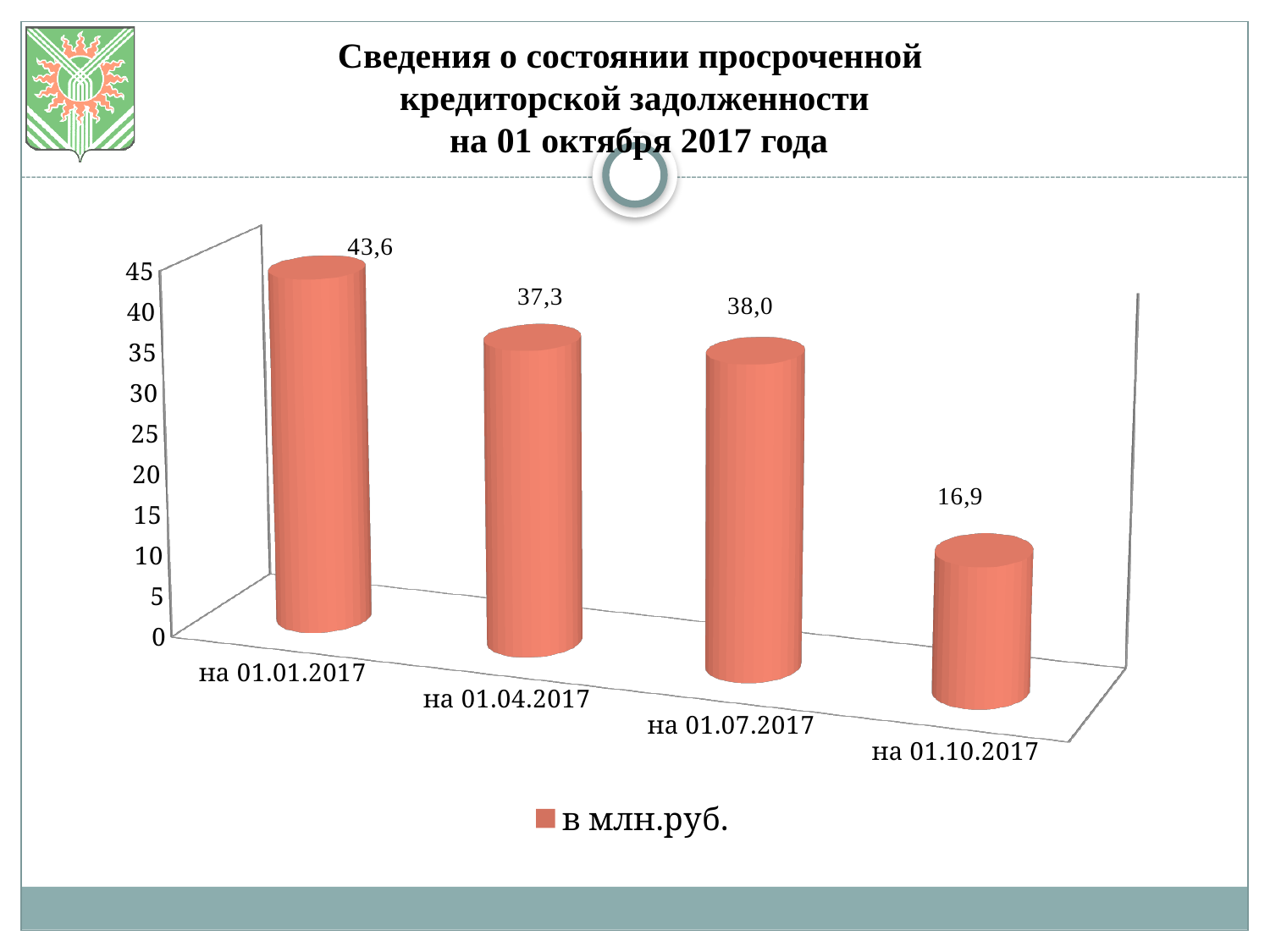
What is the value for на 01.01.2017? 43,6 What is the value for на 01.10.2017? 16,9 What is the difference between the values for на 01.01.2017 and на 01.10.2017? 26,7 How many dates are shown on the x axis? 4 What is the value for на 01.04.2017? 37,3 What is the difference between the values for на 01.07.2017 and на 01.04.2017? 0,7 Which is larger, the value for на 01.04.2017 or на 01.07.2017? на 01.07.2017 Which date has the lowest value? на 01.10.2017 How many series does the legend list? 1 Which date has the highest value? на 01.01.2017 What is the legend entry of the chart? в млн.руб. What kind of chart is shown on the slide? bar chart